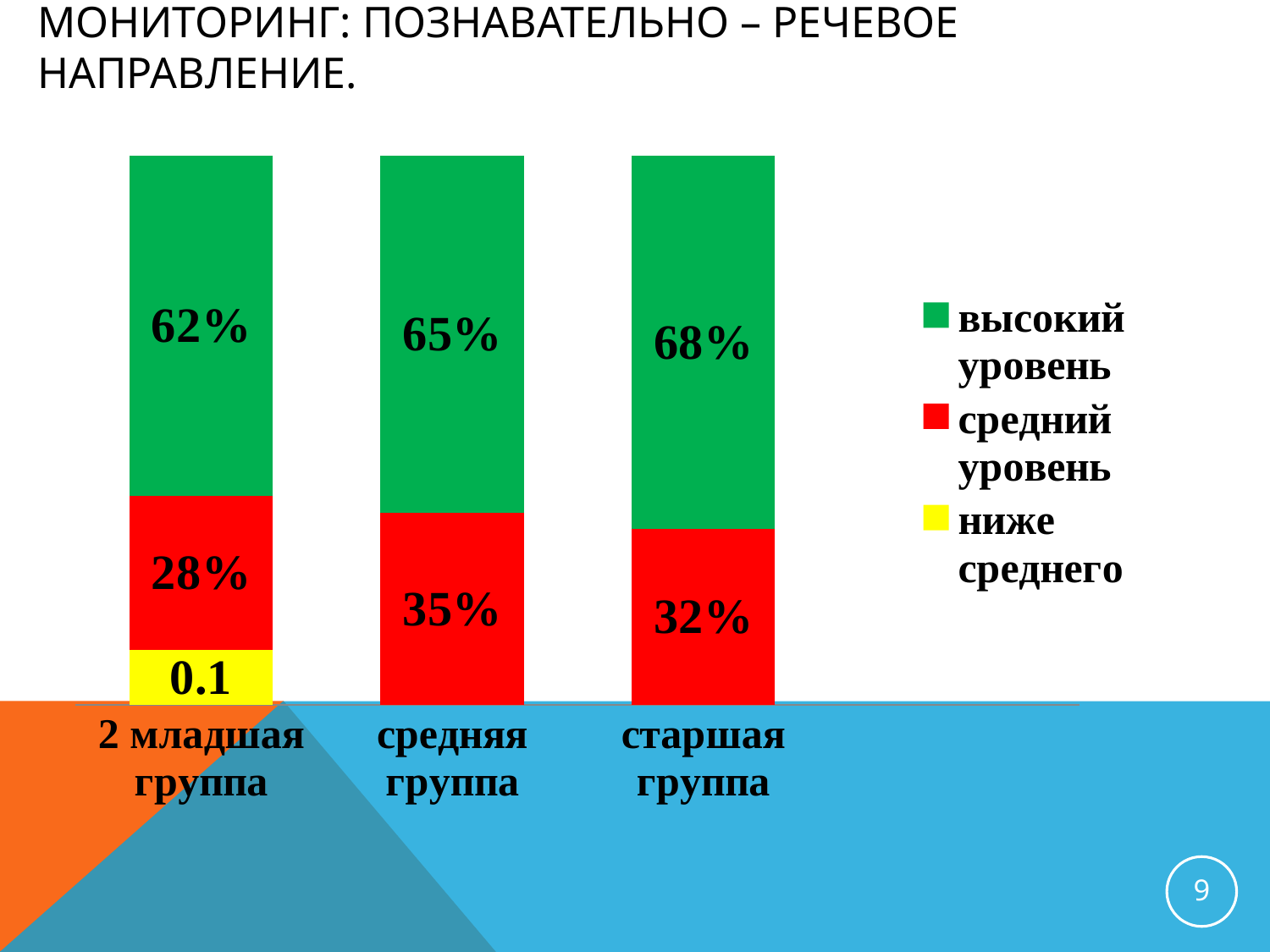
How many series does the legend list? 3 Which group has the highest value for высокий уровень? старшая группа What is the value of средний уровень for средняя группа? 35% What is the difference between высокий уровень for старшая группа and for 2 младшая группа? 6% What is the value of высокий уровень for 2 младшая группа? 62% Which is larger: средний уровень for средняя группа or for старшая группа? средняя группа What label is shown on the yellow (ниже среднего) segment for 2 младшая группа? 0.1 How many groups (categories) are shown on the x axis? 3 What is the value of высокий уровень for старшая группа? 68% What is the value of средний уровень for 2 младшая группа? 28% What kind of chart is shown on the slide? stacked bar chart Which group has the lowest value for средний уровень? 2 младшая группа